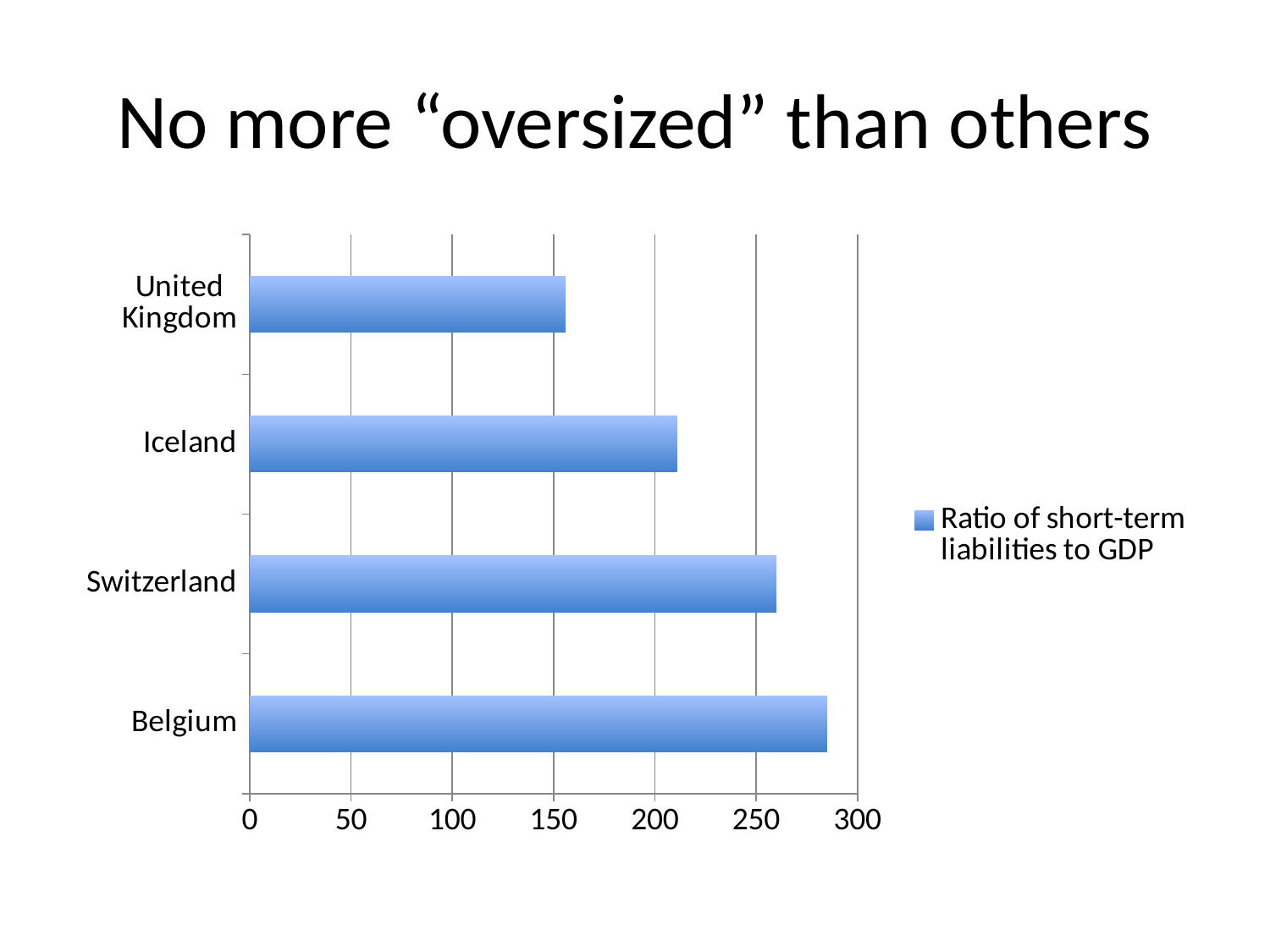
Is the value for Iceland greater or less than 200? greater Which has a larger ratio of short-term liabilities to GDP, the United Kingdom or Belgium? Belgium How many series does the legend list? 1 What series name does the legend show? Ratio of short-term liabilities to GDP How many countries are shown in the chart? 4 What kind of chart is shown on the slide? bar chart Which has a larger ratio of short-term liabilities to GDP, Iceland or Switzerland? Switzerland Is the value for Belgium greater or less than 300? less Which country has the highest ratio of short-term liabilities to GDP? Belgium Which country has the lowest ratio of short-term liabilities to GDP? United Kingdom Is the value for the United Kingdom greater or less than 200? less